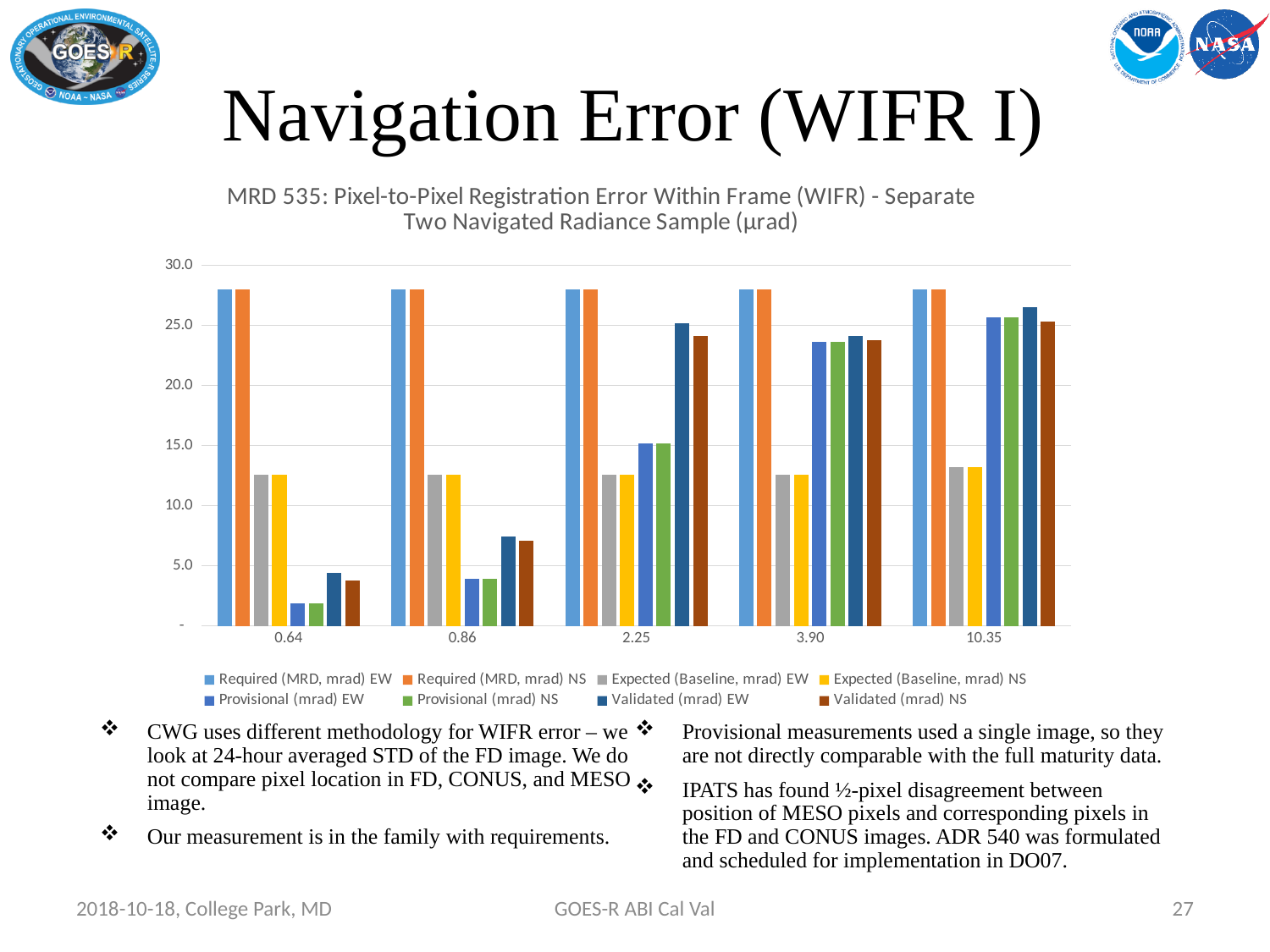
Is the value of Provisional (mrad) EW for category 0.86 greater or less than 5.0? less Which is larger: Provisional (mrad) EW for category 0.86 or for category 2.25? 2.25 Is the value of Expected (Baseline, mrad) EW for category 0.64 greater or less than 10.0? greater Is the value of Validated (mrad) EW for category 0.64 greater or less than 5.0? less How many categories are shown on the x axis of the chart? 5 Do the values of Provisional (mrad) EW rise or fall from category 0.64 to category 10.35? rise Which category has the highest value for Validated (mrad) EW? 10.35 How many series does the chart's legend list? 8 Which category has the lowest value for Validated (mrad) EW? 0.64 What kind of chart is shown on the slide? bar chart